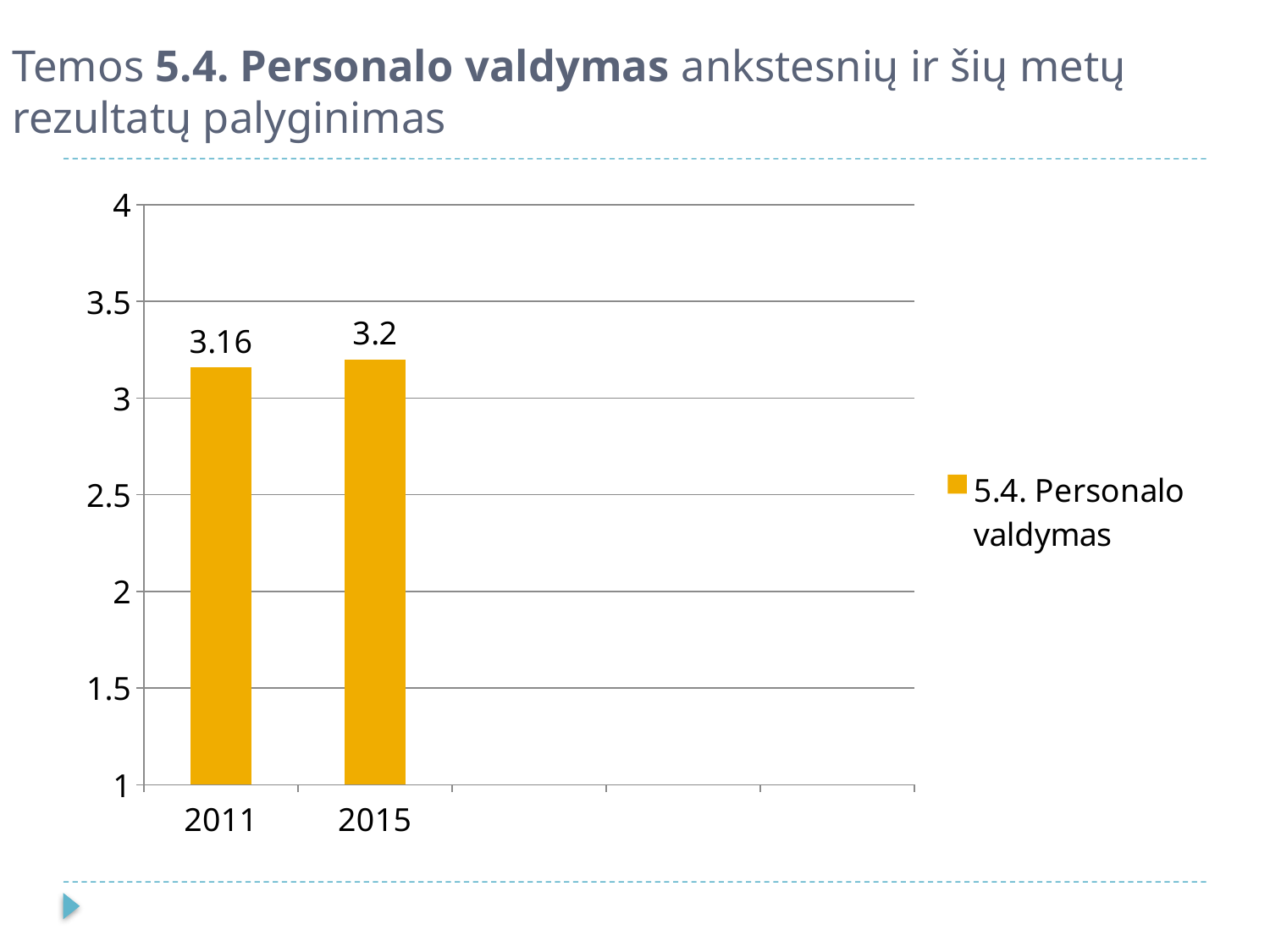
What is the value for 2015? 3.2 How many series does the legend list? 1 Which year has the lower value? 2011 What kind of chart is shown on the slide? Bar chart What is the value for 2011? 3.16 What is the difference between the values for 2015 and 2011? 0.04 Which year has the higher value? 2015 How many bars are shown in the chart? 2 What is the name of the series shown in the legend? 5.4. Personalo valdymas Is the value for 2015 larger than the value for 2011? Yes Is the value for 2011 greater or less than 3.5? less Is the value for 2015 greater or less than 3? greater